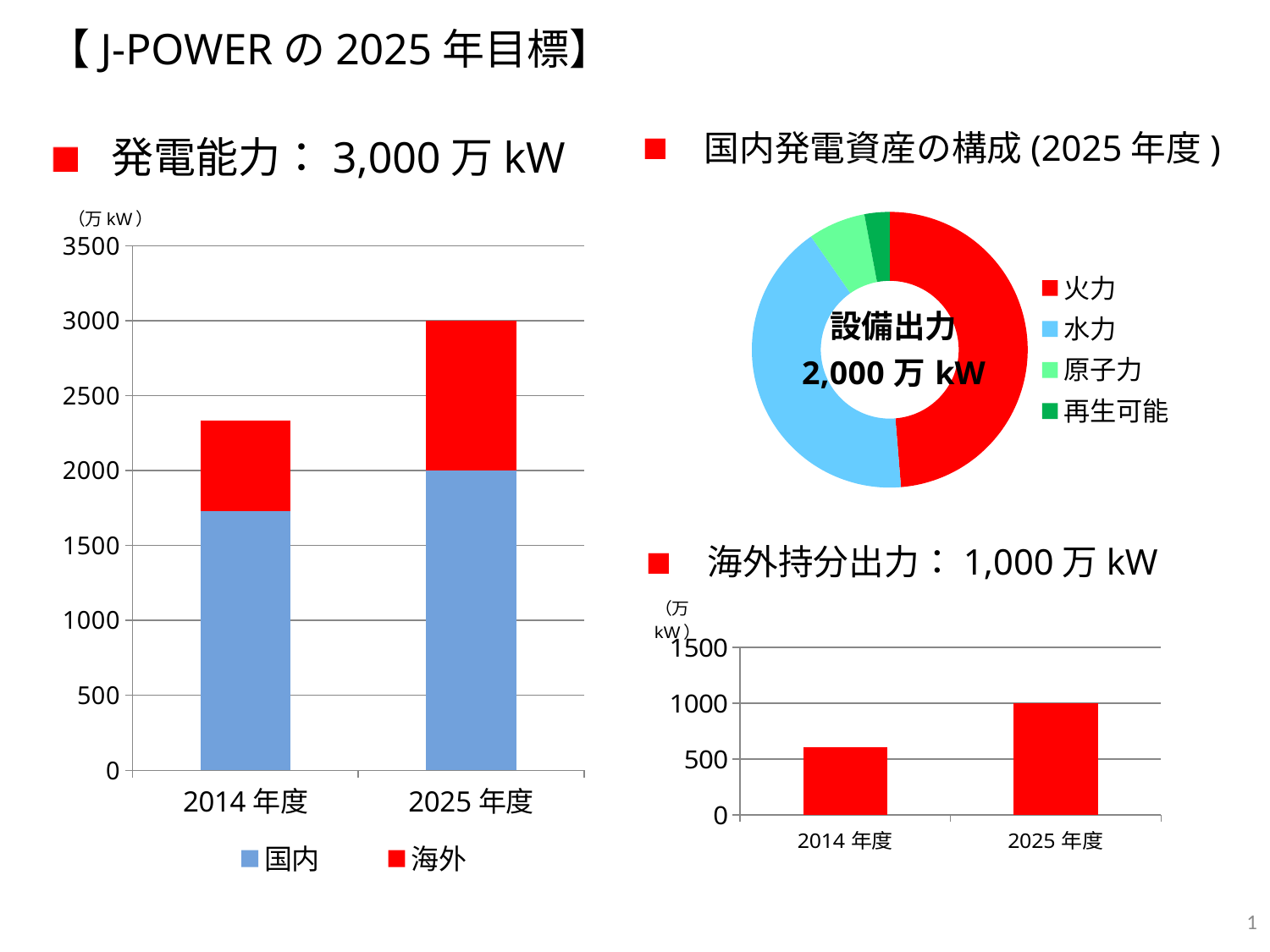
In the left chart (発電能力), what are the two legend entries? 国内, 海外 In the bottom-right chart (海外持分出力), what is the value for 2025年度? 1000 In the left chart (発電能力), what is the total height of the stacked bar for 2025年度? 3000 In the top-right donut chart (国内発電資産の構成), which category has the largest slice? 火力 In the top-right donut chart (国内発電資産の構成), how many categories does the legend list? 4 In the left chart (発電能力), is the 国内 value for 2014年度 greater or less than 1500? greater In the top-right donut chart (国内発電資産の構成), which category has the smallest slice? 再生可能 What kind of chart is the top-right chart (国内発電資産の構成)? donut chart In the left chart (発電能力), how many series does the legend list? 2 In the left chart (発電能力), is the total for 2014年度 greater or less than 2500? less In the left chart (発電能力), which year has the larger total, 2014年度 or 2025年度? 2025年度 What kind of chart is the chart on the left of the slide (発電能力)? stacked bar chart